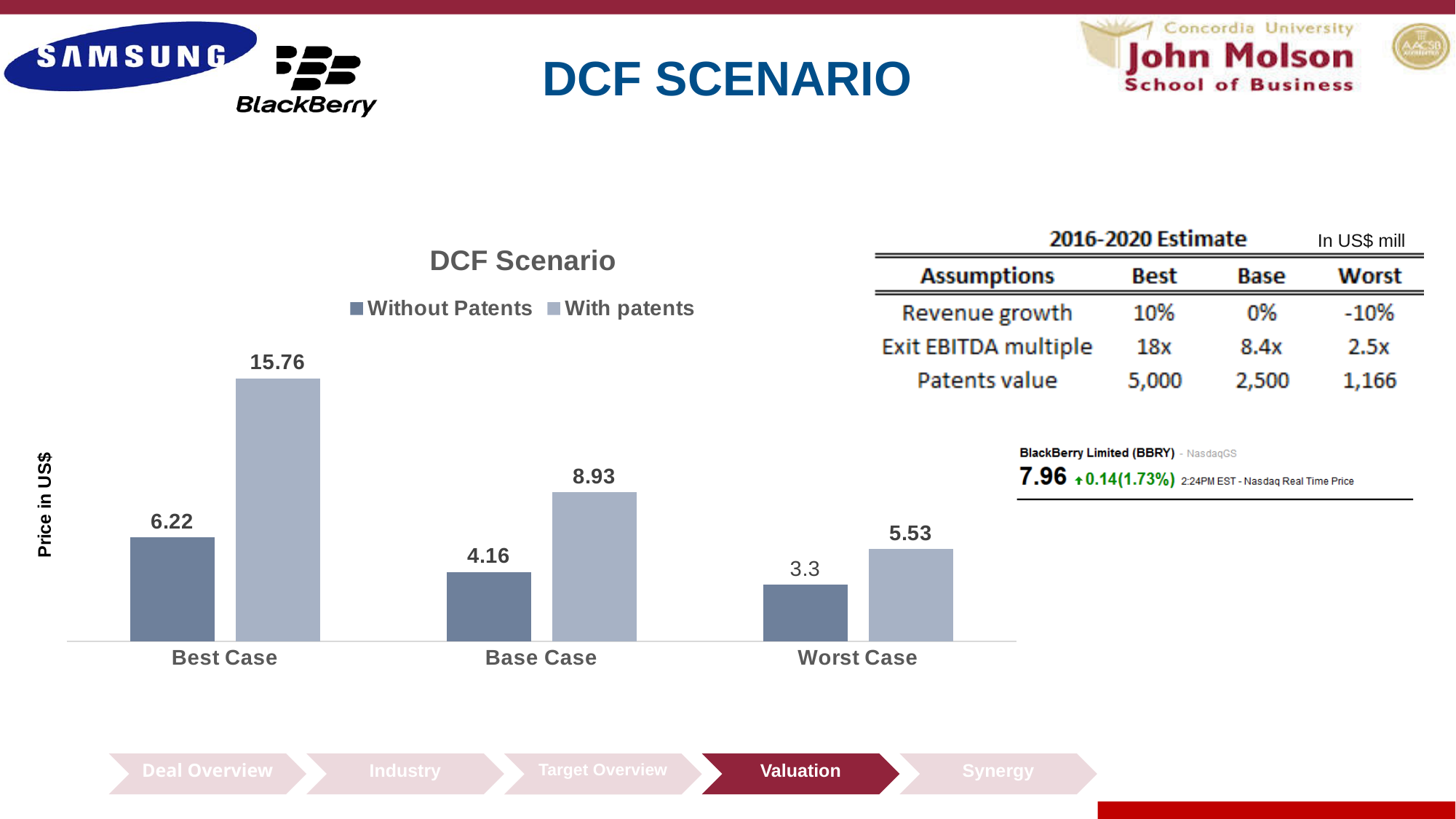
Which case has the lowest Without Patents value? Worst Case What is the value for Without Patents in the Worst Case? 3.3 What is the value for With patents in the Base Case? 8.93 Which is larger: the Without Patents value in the Base Case or the With patents value in the Worst Case? With patents in the Worst Case What is the value for Without Patents in the Best Case? 6.22 Which case has the highest With patents value? Best Case What is the y-axis label of the chart? Price in US$ What kind of chart is shown? Bar chart How many cases are shown on the x axis of the chart? 3 What is the value for With patents in the Worst Case? 5.53 How many series does the legend list? 2 What is the difference between the With patents and Without Patents values in the Best Case? 9.54